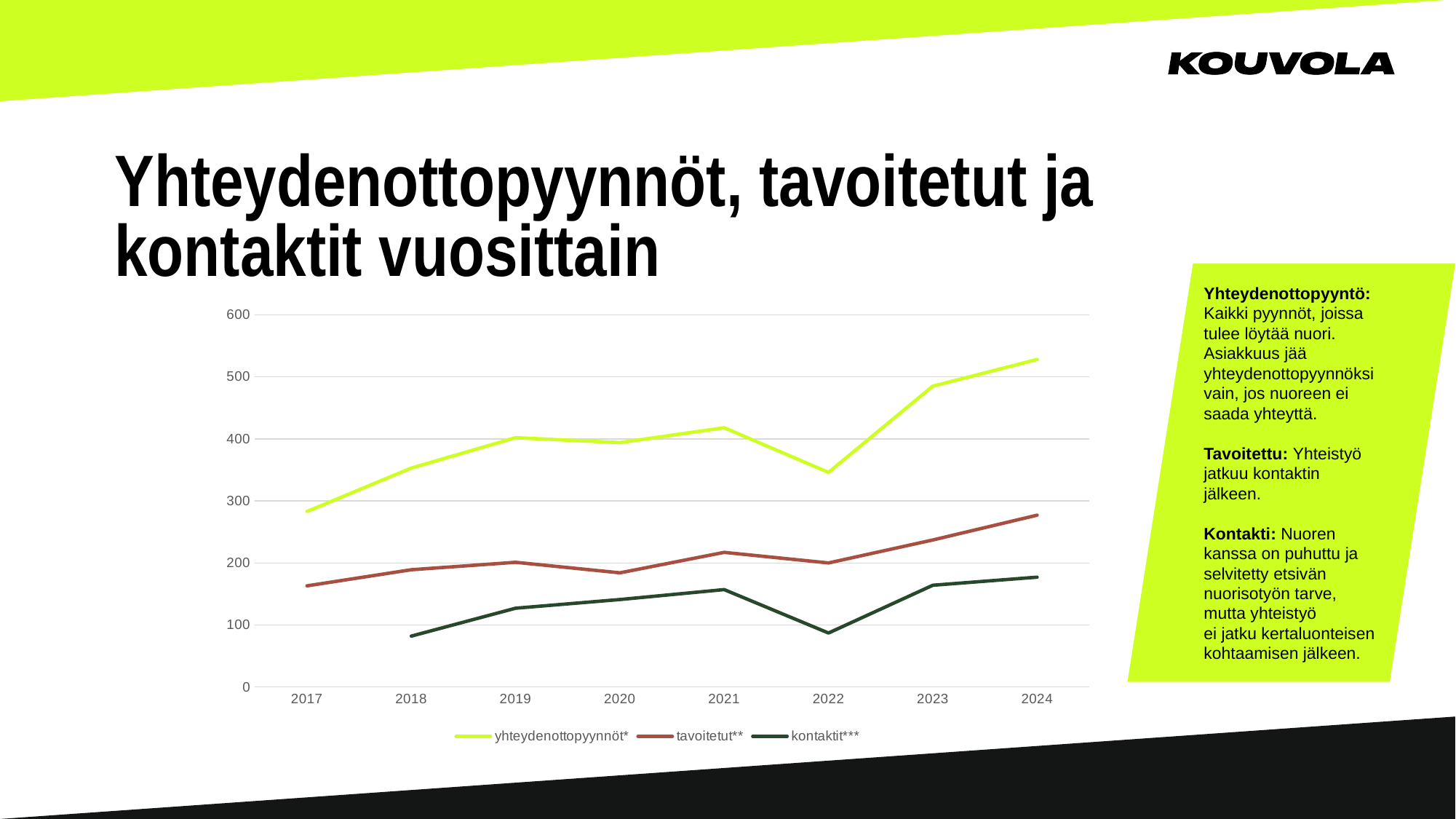
Is the value for yhteydenottopyynnöt* in 2022 greater or less than 400? less Do the values for yhteydenottopyynnöt* rise or fall from 2022 to 2024? rise How many years are shown on the x axis? 8 In which year is the value for tavoitetut** highest? 2024 How many series does the legend list? 3 Which is larger for yhteydenottopyynnöt*: the value in 2021 or the value in 2022? 2021 Is the value for kontaktit*** in 2018 greater or less than 100? less What kind of chart is shown on the slide? line chart In which year is the value for yhteydenottopyynnöt* highest? 2024 In which year is the value for yhteydenottopyynnöt* lowest? 2017 Which series in the legend has no data point for 2017? kontaktit*** Is the value for yhteydenottopyynnöt* in 2024 greater or less than 500? greater